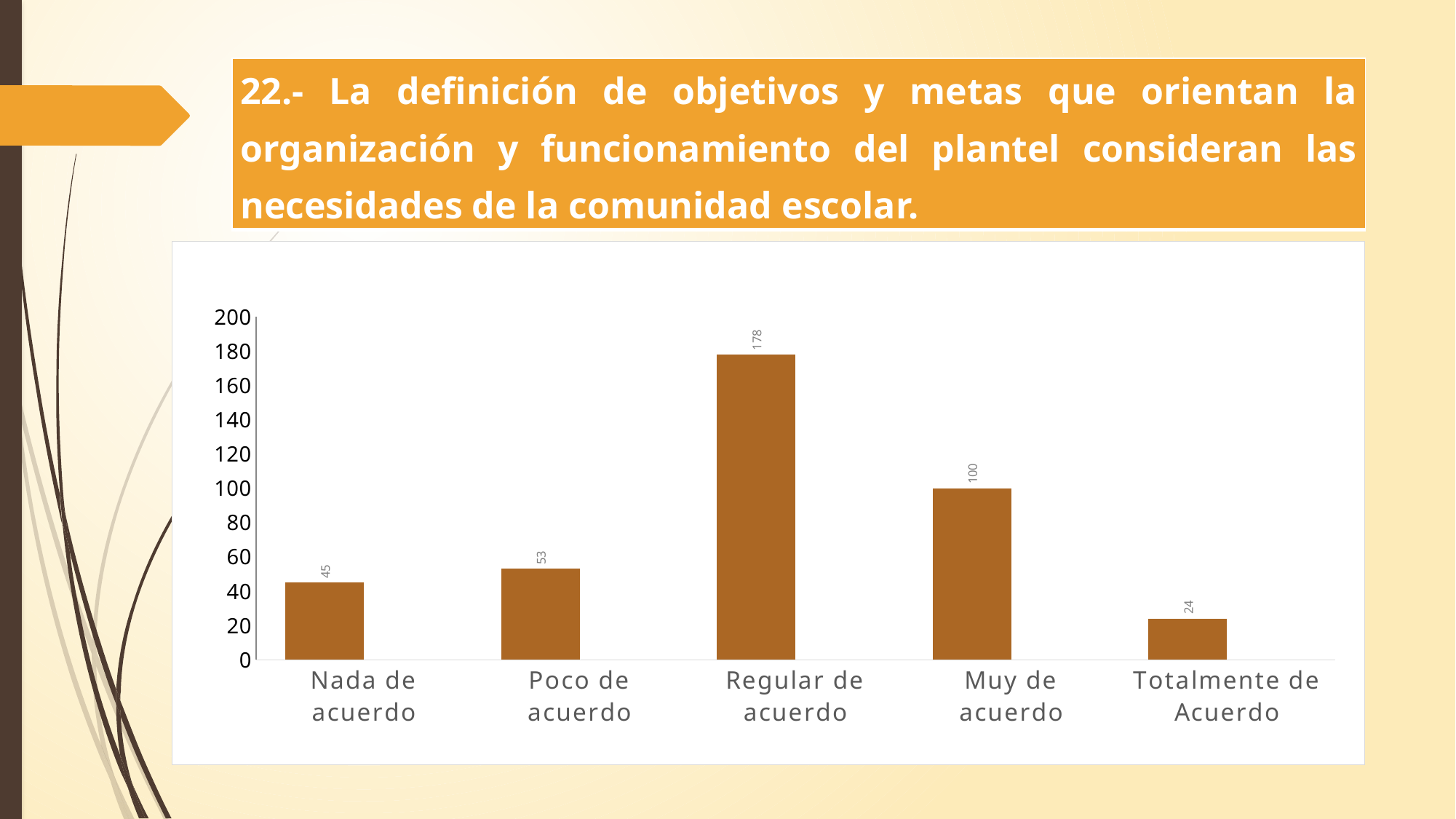
What is the value for "Totalmente de Acuerdo"? 24 What kind of chart is shown on the slide? bar chart What is the total of all five bar values? 400 What is the value for "Regular de acuerdo"? 178 What is the value for "Poco de acuerdo"? 53 Is the value for "Muy de acuerdo" greater or less than 80? greater What is the difference between the values for "Regular de acuerdo" and "Muy de acuerdo"? 78 Which category has the highest value? Regular de acuerdo What is the maximum value shown on the vertical axis? 200 Which is larger, the value for "Nada de acuerdo" or the value for "Poco de acuerdo"? Poco de acuerdo How many categories are shown on the x axis? 5 Which category has the lowest value? Totalmente de Acuerdo